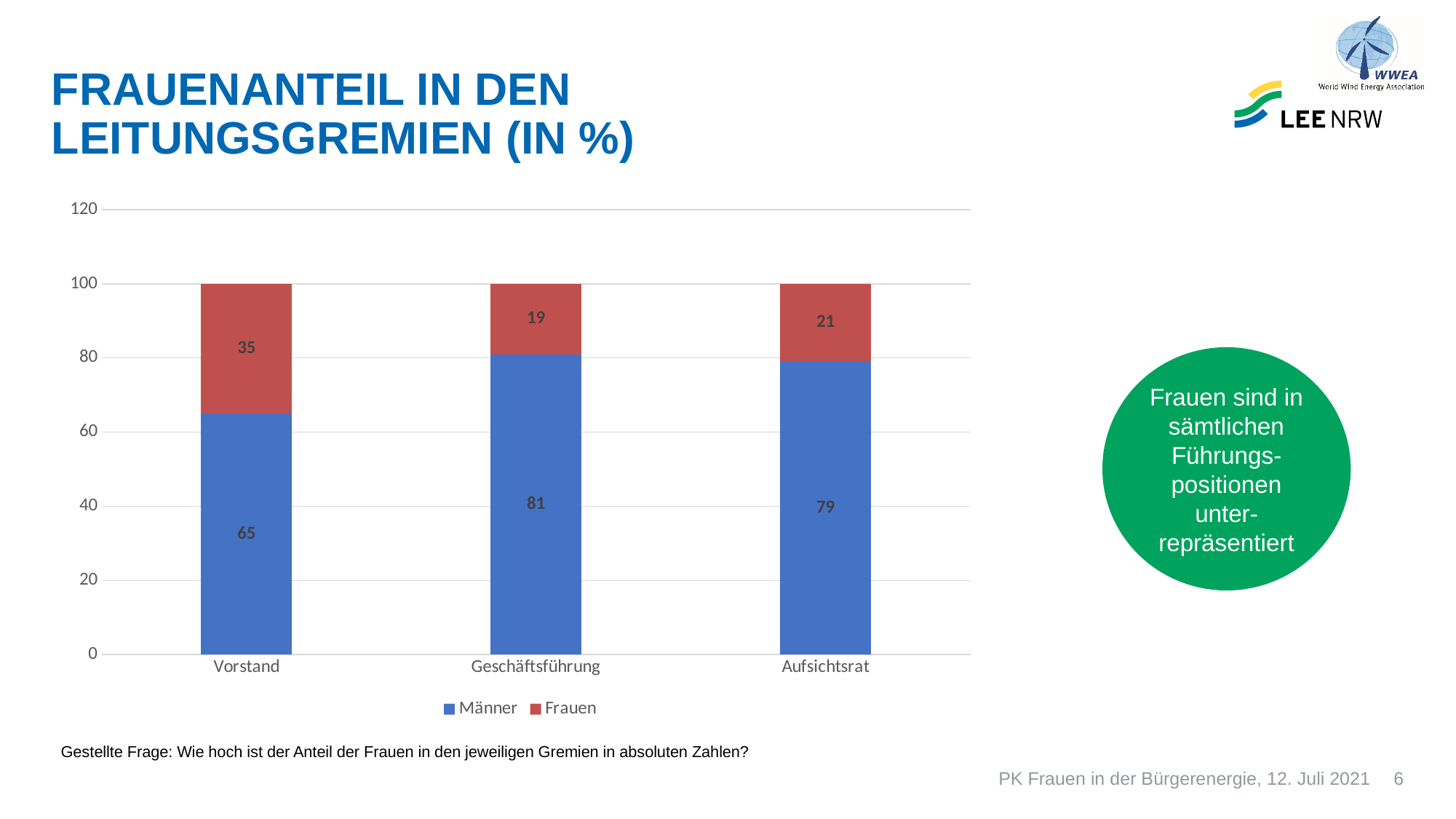
What is the total of the stacked bar for Aufsichtsrat? 100 Which category has the lowest value for Männer? Vorstand What is the value for Männer in Geschäftsführung? 81 Which is larger: the Frauen value for Geschäftsführung or the Frauen value for Aufsichtsrat? Aufsichtsrat What is the difference between the Männer value for Geschäftsführung and the Männer value for Vorstand? 16 What kind of chart is shown on the slide? Stacked bar chart What is the value for Frauen in Vorstand? 35 What is the value for Frauen in Aufsichtsrat? 21 Which colour represents Frauen in the chart? Red Which category has the highest value for Frauen? Vorstand How many categories are shown on the x axis? 3 How many series does the legend list? 2